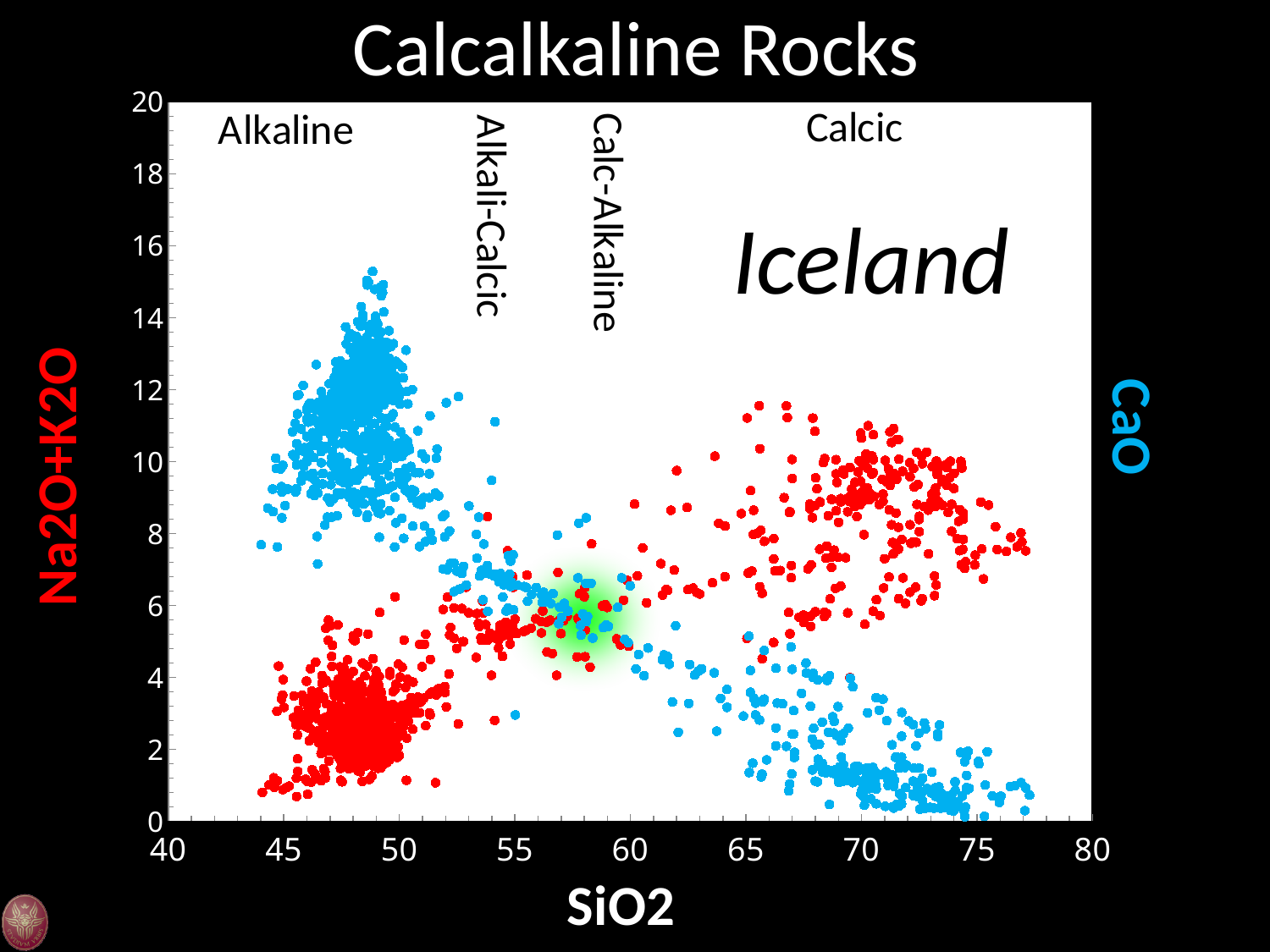
Which region or country is named on the chart? Iceland Are the blue CaO values at SiO2 around 75 greater or less than 4? less Are the red Na2O+K2O values at SiO2 around 48 greater or less than 6? less What kind of chart is shown on the slide? scatter plot At SiO2 around 75, which series has the higher values, red Na2O+K2O or blue CaO? red Na2O+K2O Do the blue CaO points rise or fall as SiO2 increases along the x axis? fall Are the red Na2O+K2O values at SiO2 around 70 greater or less than 4? greater How many data series (colours of points) are plotted on the chart? 2 What is the title of the chart? Calcalkaline Rocks Do the red Na2O+K2O points rise or fall as SiO2 increases along the x axis? rise At SiO2 around 47, which series has the higher values, red Na2O+K2O or blue CaO? blue CaO